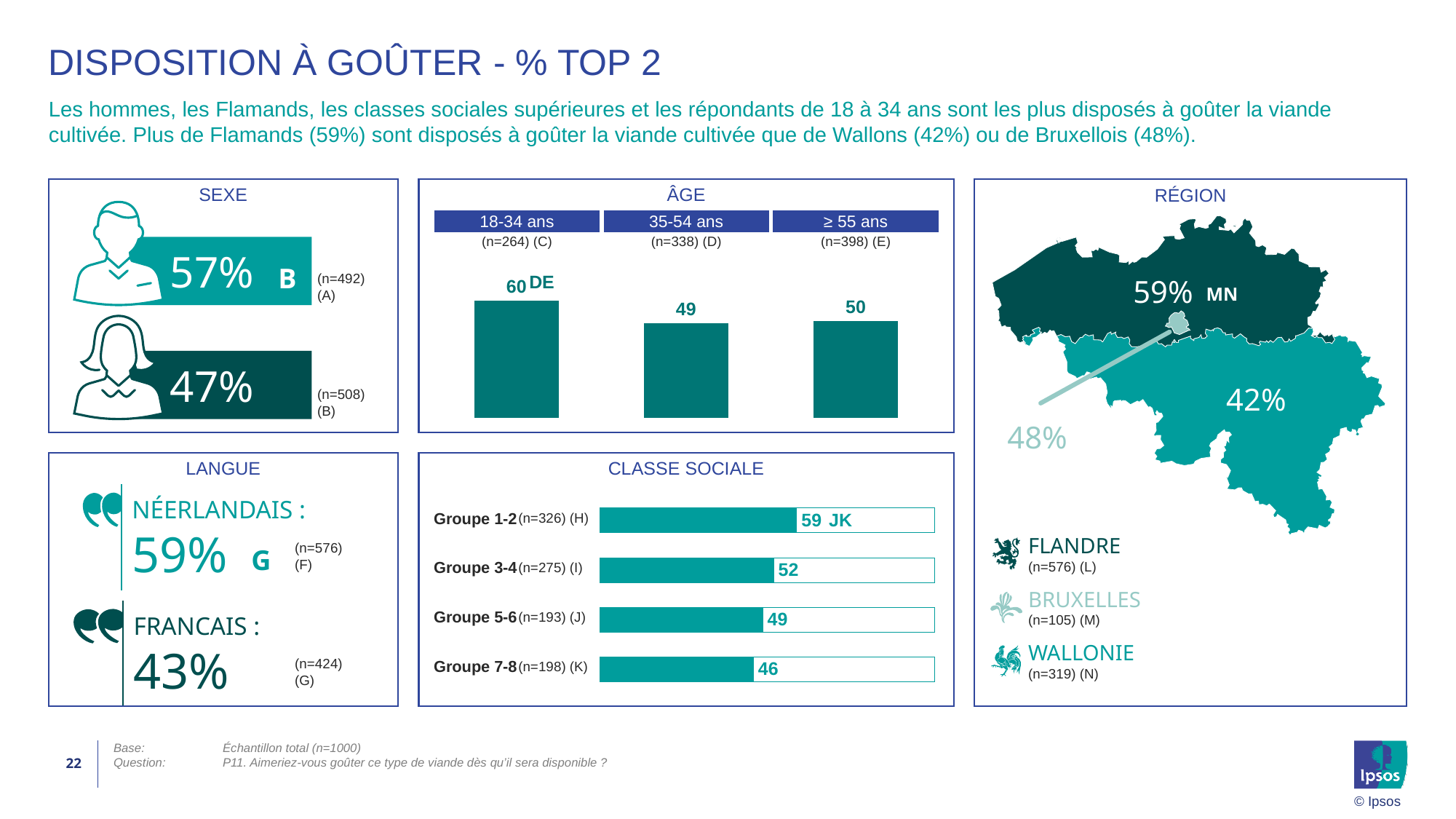
In the CLASSE SOCIALE chart, which is larger, the value for Groupe 1-2 or the value for Groupe 5-6? Groupe 1-2 In the ÂGE chart, what is the value for the 18-34 ans group? 60 In the CLASSE SOCIALE chart, what is the difference between Groupe 1-2 and Groupe 7-8? 13 In the ÂGE chart, which age group has the highest value? 18-34 ans What kind of chart is the ÂGE chart? Bar chart In the CLASSE SOCIALE chart, which group has the lowest value? Groupe 7-8 In the RÉGION map, what is the value shown for Wallonie? 42% In the CLASSE SOCIALE chart, do the values rise or fall from Groupe 1-2 down to Groupe 7-8? Fall In the CLASSE SOCIALE chart, what is the value for Groupe 3-4? 52 In the ÂGE chart, what is the value for the 35-54 ans group? 49 In the ÂGE chart, how many age groups are shown? 3 In the ÂGE chart, what is the difference between the 18-34 ans value and the ≥ 55 ans value? 10